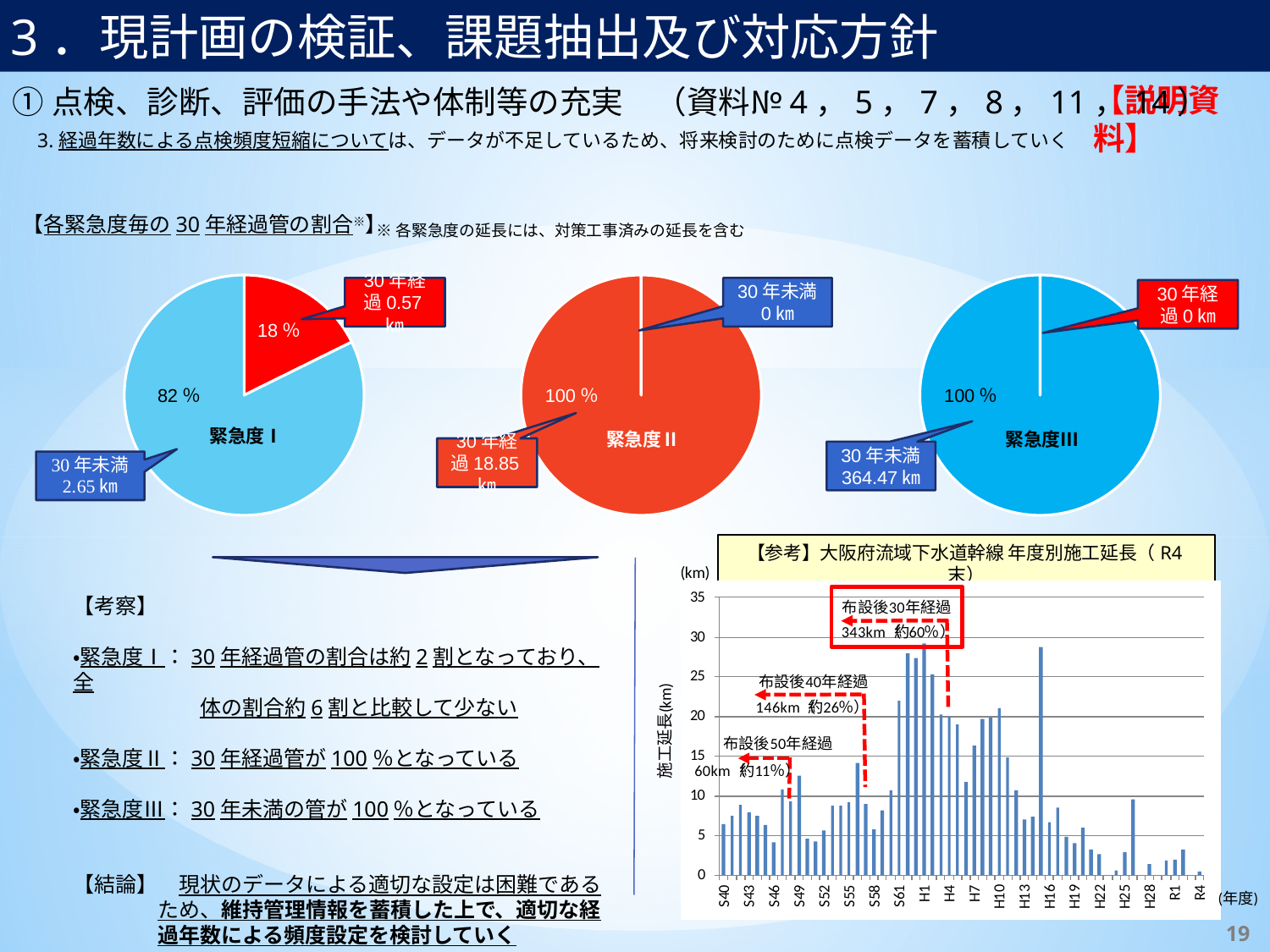
In the 大阪府流域下水道幹線 年度別施工延長 bar chart, is the value for R4 greater or less than 5? less In the 緊急度Ⅰ pie chart, what is the difference in percentage points between the 30年未満 and 30年経過 slices? 64 In the 緊急度Ⅰ pie chart, what length is shown for 30年未満? 2.65km In the 緊急度Ⅰ pie chart, what percentage of the pipes are 30年経過? 18% In the 緊急度Ⅰ pie chart, what length is shown for 30年経過? 0.57km In the 緊急度Ⅲ pie chart, what length is shown for 30年未満? 364.47km In the 大阪府流域下水道幹線 年度別施工延長 bar chart, is the value for H16 greater or less than 25? greater What kind of chart is the 大阪府流域下水道幹線 年度別施工延長 chart at the bottom right? bar chart In the 緊急度Ⅲ pie chart, what length is shown for 30年経過? 0km In the 緊急度Ⅱ pie chart, what percentage of the pipes are 30年経過? 100% In the 緊急度Ⅰ pie chart, which slice is larger, 30年未満 or 30年経過? 30年未満 In the 緊急度Ⅱ pie chart, what length is shown for 30年経過? 18.85km